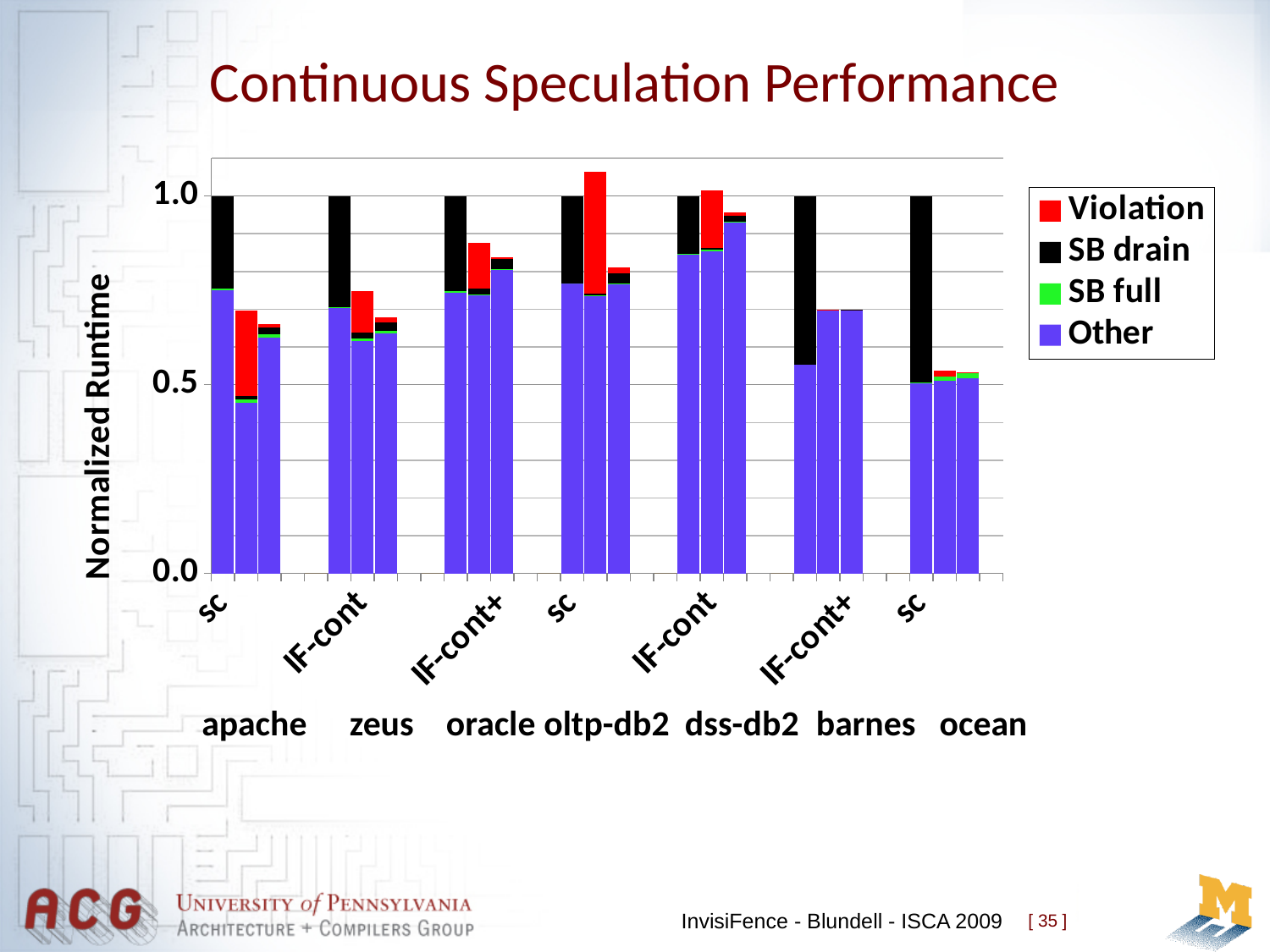
How many benchmark groups are shown along the x axis? 7 What is the total normalized runtime of the sc bar for ocean? 1.0 Which benchmark has the lowest IF-cont+ bar? ocean Is the total of the IF-cont+ bar for apache greater or less than 1.0? less For barnes, which bar is taller: sc or IF-cont? sc How many series does the legend list? 4 Is the total of the IF-cont bar for oltp-db2 greater or less than 1.0? greater What is the title of the y axis? Normalized Runtime Is the total of the IF-cont bar for barnes greater or less than 0.5? greater What kind of chart is shown on the slide? stacked bar chart What is the total normalized runtime of the sc bar for apache? 1.0 For oltp-db2, which bar is taller: IF-cont or IF-cont+? IF-cont